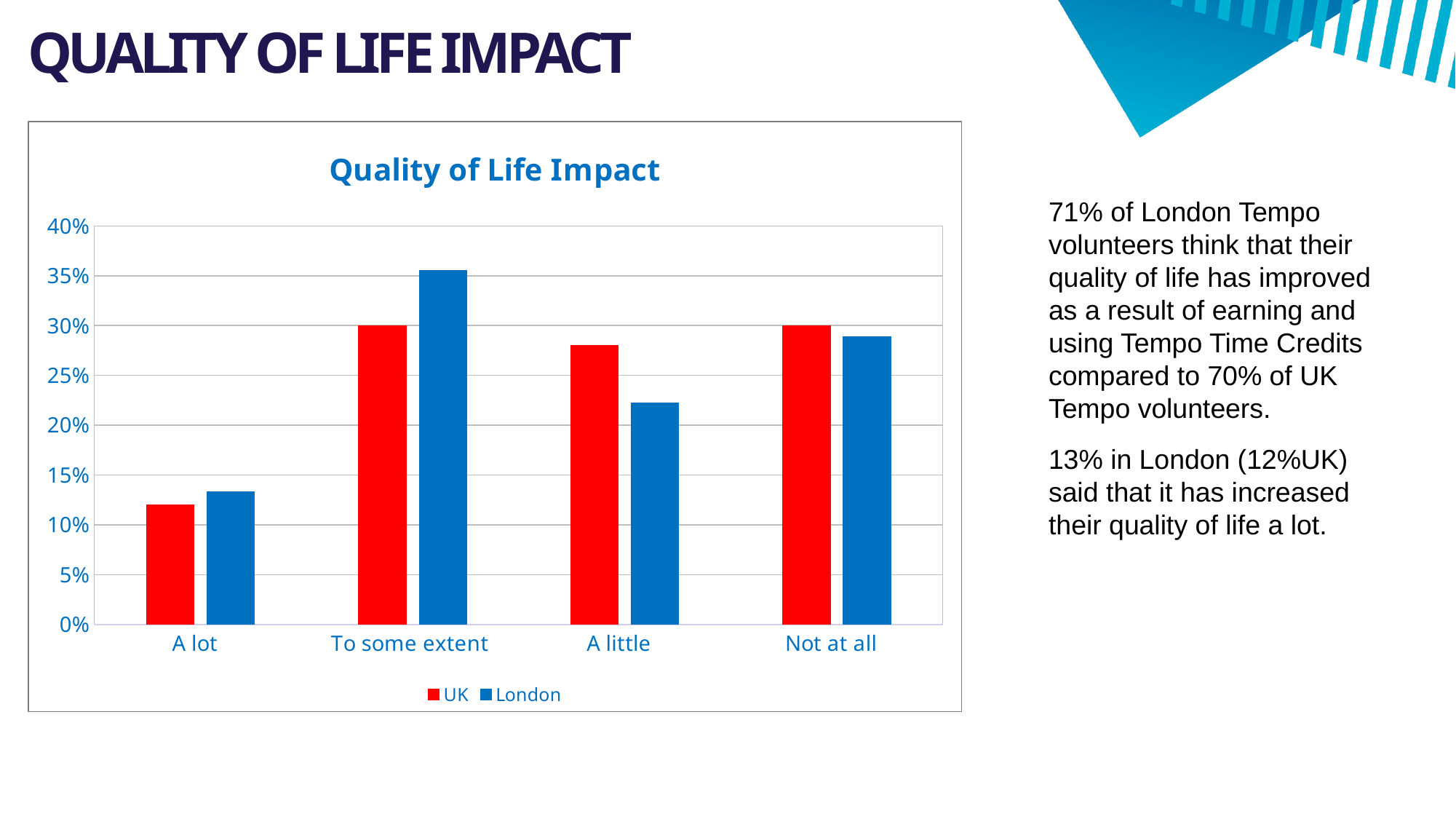
For the London series, which category has the highest value? To some extent What kind of chart is shown on the slide? bar chart Is the London value for 'To some extent' greater or less than 30%? greater Is the London value for 'A little' greater or less than 25%? less In the 'To some extent' category, which series has the larger value, UK or London? London Which series is shown in red in the chart? UK What is the title of the chart? Quality of Life Impact For the London series, which category has the lowest value? A lot How many series does the chart's legend list? 2 How many categories are shown on the x axis of the chart? 4 For the UK series, which category has the lowest value? A lot In the 'A little' category, which series has the larger value, UK or London? UK